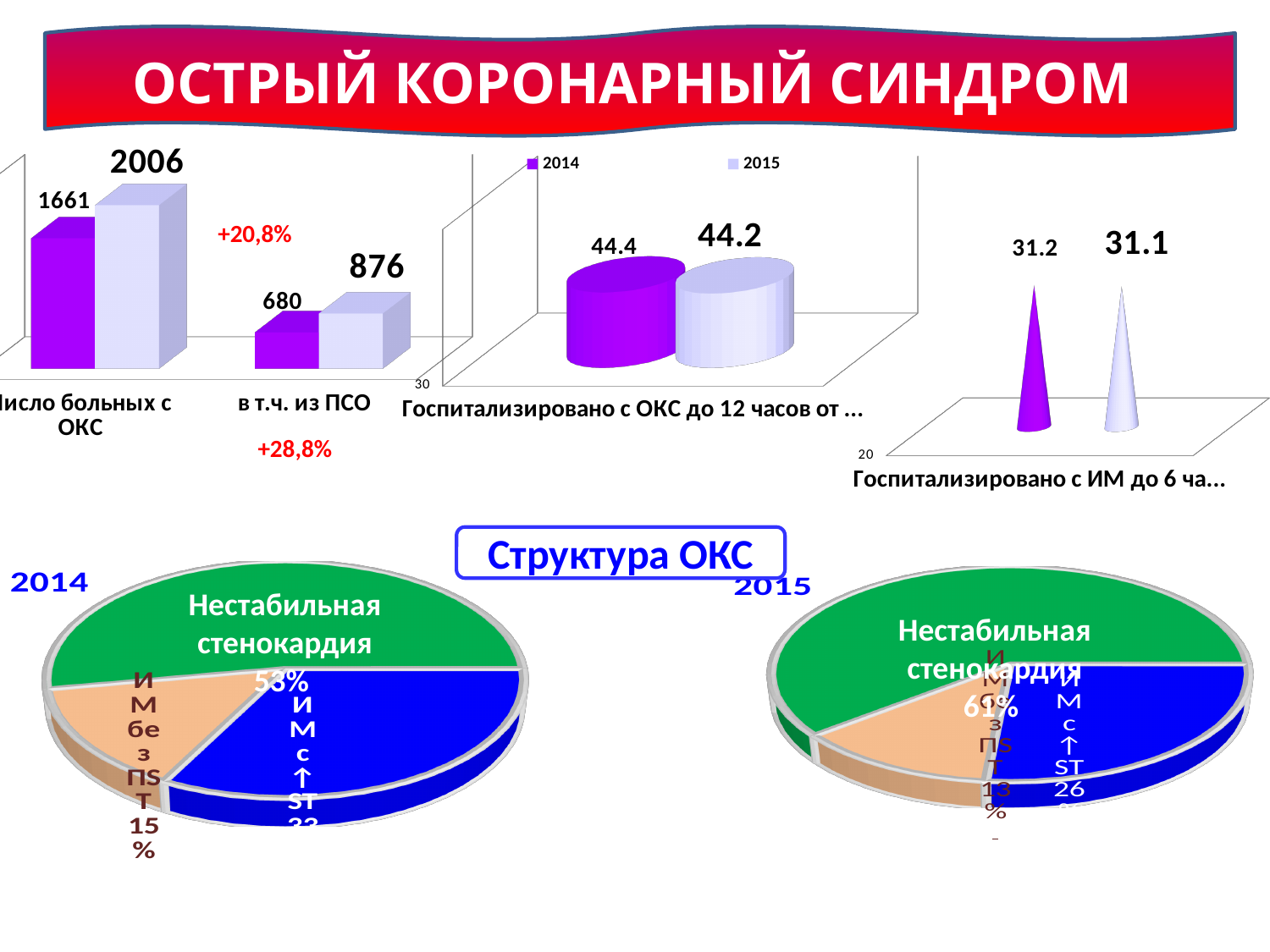
In the 2014 pie chart under "Структура ОКС", what share is "Нестабильная стенокардия"? 53% In the chart titled "Госпитализировано с ИМ до 6 ча...", what is the 2015 value? 31.1 What kind of chart is the top-left chart showing "Число больных с ОКС"? bar chart In the top-left bar chart, what is the 2014 value for "Число больных с ОКС"? 1661 How many slices does the 2014 pie chart under "Структура ОКС" have? 3 In the top-left bar chart, what is the 2015 value for "в т.ч. из ПСО"? 876 In the chart titled "Госпитализировано с ОКС до 12 часов от ...", what is the 2014 value? 44.4 In the 2015 pie chart under "Структура ОКС", what share is "Нестабильная стенокардия"? 61% In the top-left bar chart, what percentage change is annotated next to "в т.ч. из ПСО"? +28,8% In the top-left bar chart, what is the difference between the 2015 and 2014 values for "Число больных с ОКС"? 345 In the chart titled "Госпитализировано с ОКС до 12 часов от ...", how many series does the legend list? 2 In the top-left bar chart, which year has the larger value for "в т.ч. из ПСО", 2014 or 2015? 2015